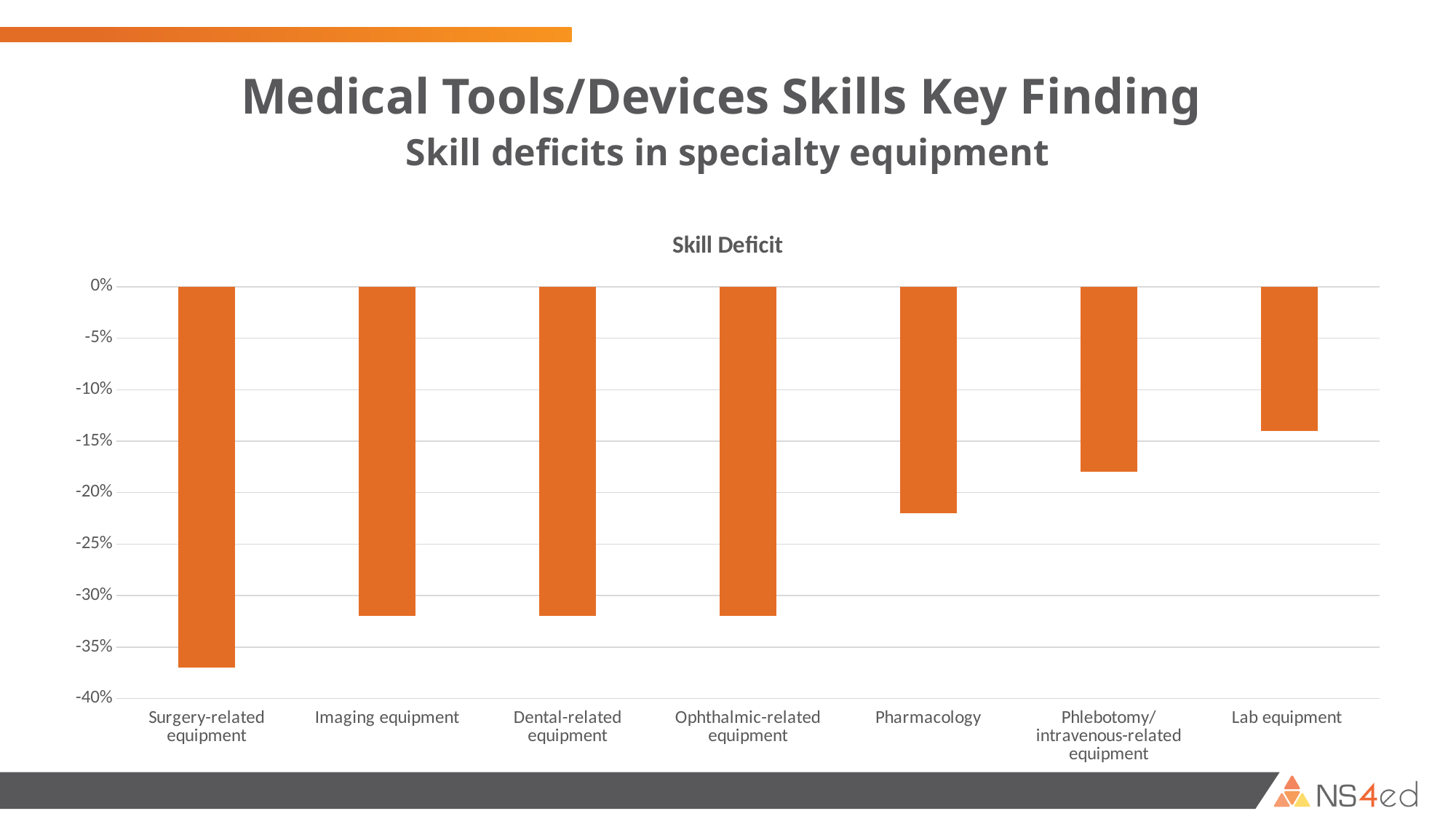
Is the value for Pharmacology greater or less than -20%? less Is the value for Lab equipment greater or less than -15%? greater Do the bar values rise or fall (move toward 0%) from left to right across the categories? rise Which category has the largest skill deficit (the most negative value)? Surgery-related equipment Is the value for Phlebotomy/intravenous-related equipment greater or less than -15%? less What kind of chart is shown on the slide? bar chart Which category has the smallest skill deficit (the value closest to 0%)? Lab equipment What is the title shown above the chart? Skill Deficit Which has the larger skill deficit, Pharmacology or Lab equipment? Pharmacology How many categories are plotted in the Skill Deficit chart? 7